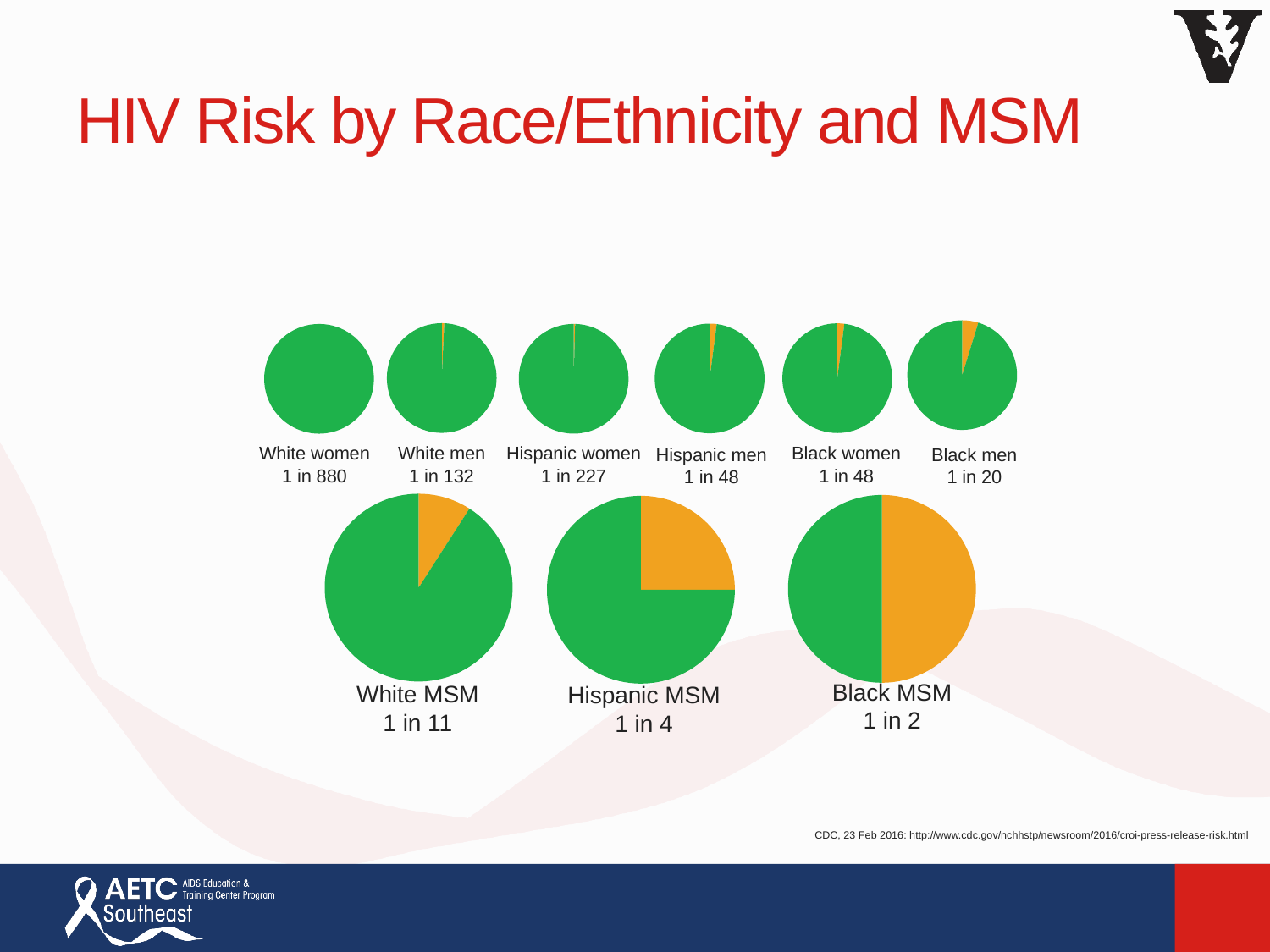
Which group on the slide has the lowest HIV risk (the smallest orange share of its pie)? White women What share of the Hispanic MSM pie is orange? 1 in 4 What kind of chart is used to show each group's HIV risk? Pie chart What is the HIV risk value shown for Black MSM? 1 in 2 How many pie charts are shown on the slide? 9 What is the HIV risk value shown for White women? 1 in 880 What is the HIV risk value shown for Hispanic men? 1 in 48 Which group on the slide has the highest HIV risk (the largest orange share of its pie)? Black MSM What is the title of the slide? HIV Risk by Race/Ethnicity and MSM What is the HIV risk value shown for Black men? 1 in 20 What is the HIV risk value shown for White MSM? 1 in 11 Which group has a higher HIV risk, Hispanic MSM or White MSM? Hispanic MSM